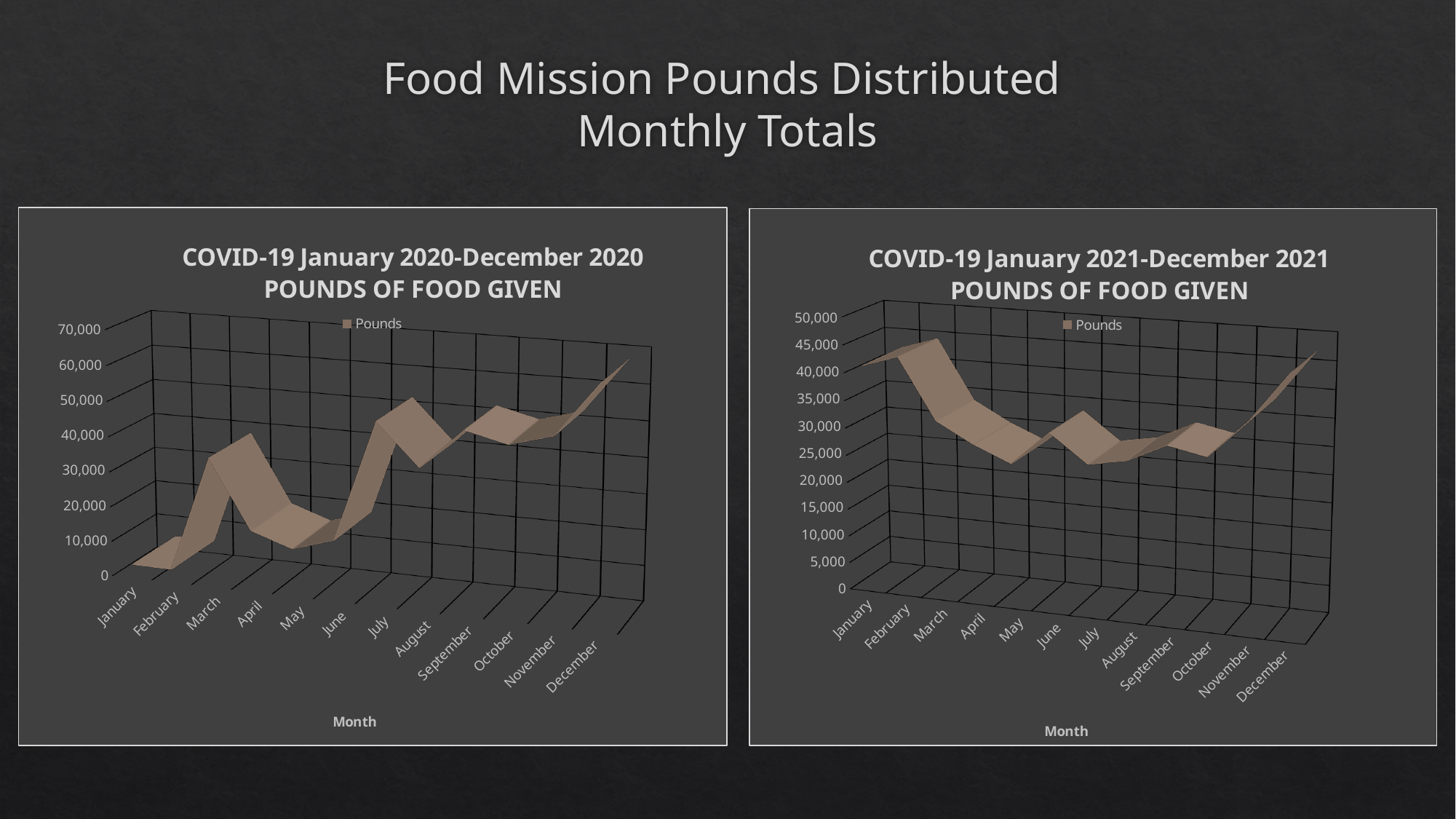
In the left chart (January 2020-December 2020), which is larger, the value for March or the value for May? March In the right chart (January 2021-December 2021), is the value for January greater or less than 30,000? greater What type of chart is the left chart, 'COVID-19 January 2020-December 2020 POUNDS OF FOOD GIVEN'? line chart What is the x-axis title of the right chart (January 2021-December 2021)? Month In the left chart (January 2020-December 2020), is the value for January greater or less than 10,000? less In the left chart (January 2020-December 2020), which month has the highest pounds of food given? December In the right chart (January 2021-December 2021), do the values rise or fall from January to May? fall How many months are plotted on the x axis of the left chart (January 2020-December 2020)? 12 In the right chart (January 2021-December 2021), is the value for May greater or less than 30,000? less How many series does the legend of the right chart (January 2021-December 2021) list? 1